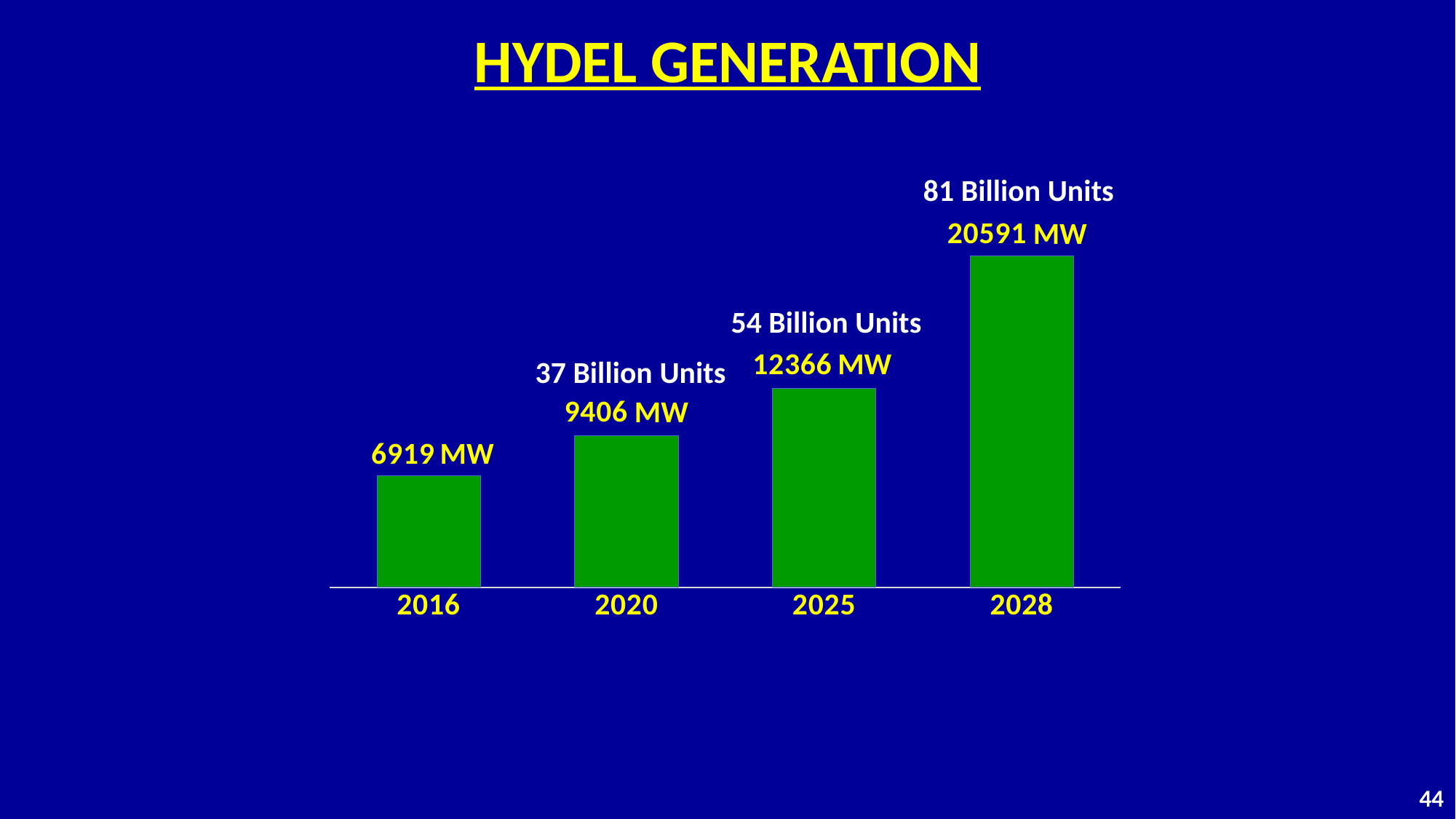
What is the hydel generation capacity shown for 2028? 20591 MW How many years are shown on the x axis? 4 How many billion units are shown for 2025? 54 Billion Units What kind of chart is shown on the slide? Bar chart What is the hydel generation capacity shown for 2016? 6919 MW Which year has the highest capacity in MW? 2028 What is the hydel generation capacity shown for 2025? 12366 MW What is the hydel generation capacity shown for 2020? 9406 MW Which is larger, the capacity for 2020 or for 2025? 2025 Which year has the lowest capacity in MW? 2016 What is the difference in MW between 2028 and 2025? 8225 MW How many billion units are shown for 2028? 81 Billion Units